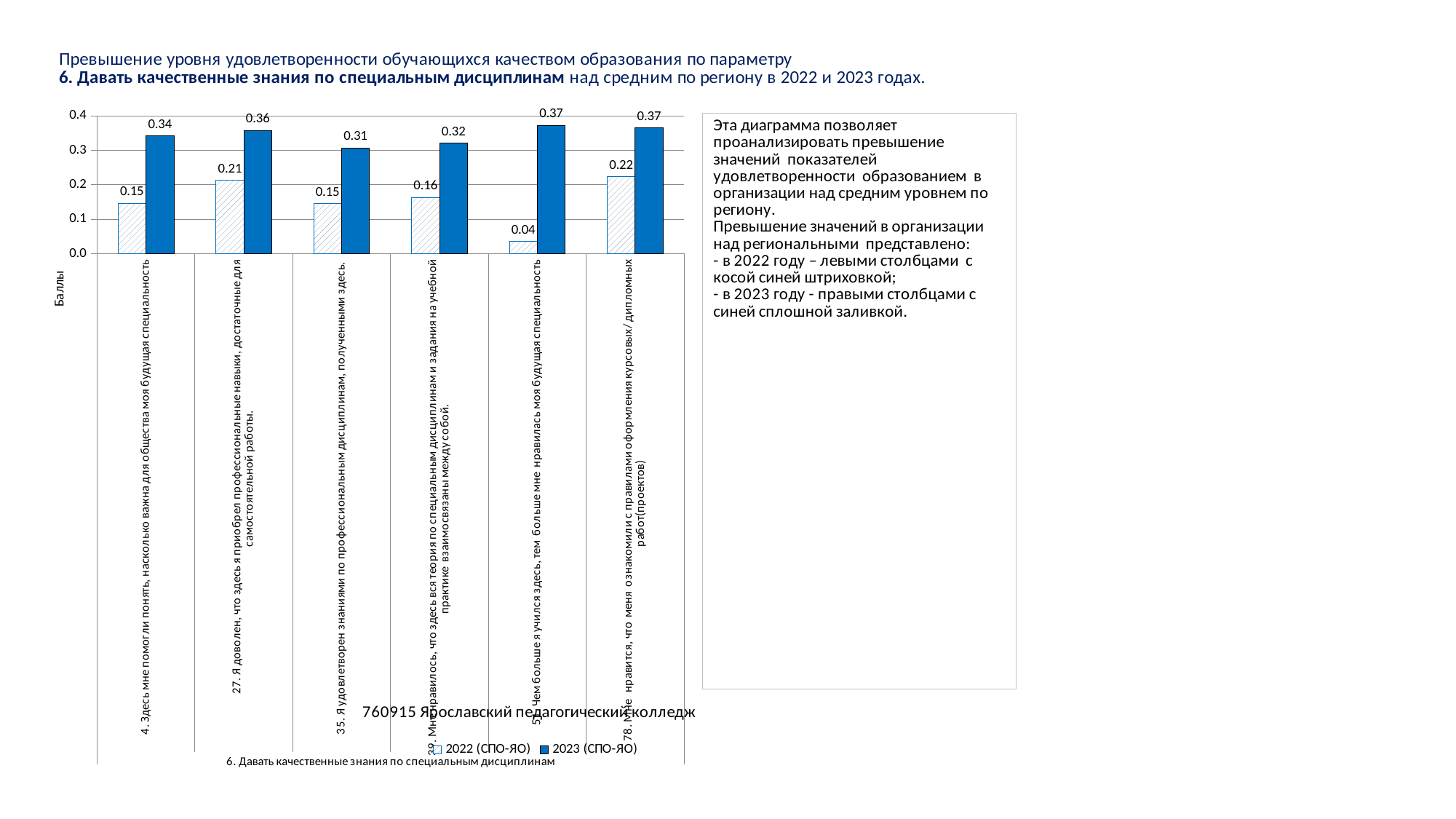
How many series does the chart legend list? 2 What is the 2022 (СПО-ЯО) value for the category "27. Я доволен, что здесь я приобрел профессиональные навыки, достаточные для самостоятельной работы"? 0.21 What is the 2022 (СПО-ЯО) value for the category "Чем больше я учился здесь, тем больше мне нравилась моя будущая специальность"? 0.04 Which category has the highest 2022 (СПО-ЯО) value? 78. Мне нравится, что меня ознакомили с правилами оформления курсовых/дипломных работ(проектов) Which is larger for the category "78. Мне нравится, что меня ознакомили с правилами оформления курсовых/дипломных работ(проектов)": the 2022 (СПО-ЯО) value or the 2023 (СПО-ЯО) value? 2023 (СПО-ЯО) What is the label of the vertical axis of the chart? Баллы What is the 2023 (СПО-ЯО) value for the category "35. Я удовлетворен знаниями по профессиональным дисциплинам, полученными здесь"? 0.31 Which category has the lowest 2022 (СПО-ЯО) value? Чем больше я учился здесь, тем больше мне нравилась моя будущая специальность What kind of chart is shown on the slide? bar chart How many categories are plotted on the x axis of the chart? 6 What is the 2023 (СПО-ЯО) value for the category "4. Здесь мне помогли понять, насколько важна для общества моя будущая специальность"? 0.34 What is the difference between the 2023 (СПО-ЯО) and 2022 (СПО-ЯО) values for the category "27. Я доволен, что здесь я приобрел профессиональные навыки, достаточные для самостоятельной работы"? 0.15